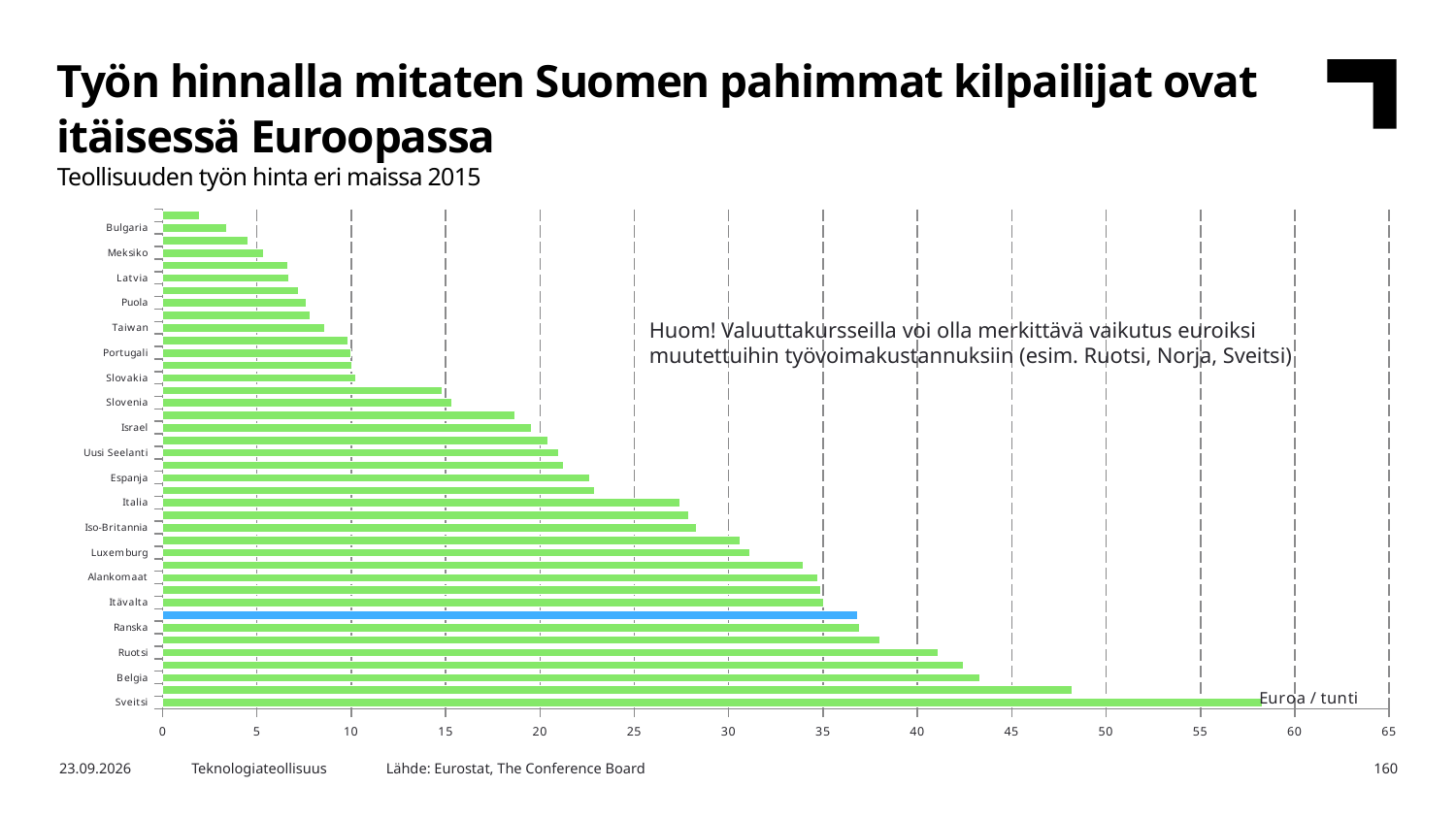
Which has the higher labour cost, Ruotsi or Espanja? Ruotsi Is the value for Belgia greater or less than 40? greater Which country has the highest labour cost in the chart? Sveitsi Is the value for Portugali greater or less than 15? less Is the value for Sveitsi greater or less than 50? greater Do the bar values increase or decrease going from the top of the chart to the bottom? increase What unit is shown on the x axis of the chart? Euroa / tunti What kind of chart is shown on the slide? bar chart Which has the lower labour cost, Bulgaria or Sveitsi? Bulgaria